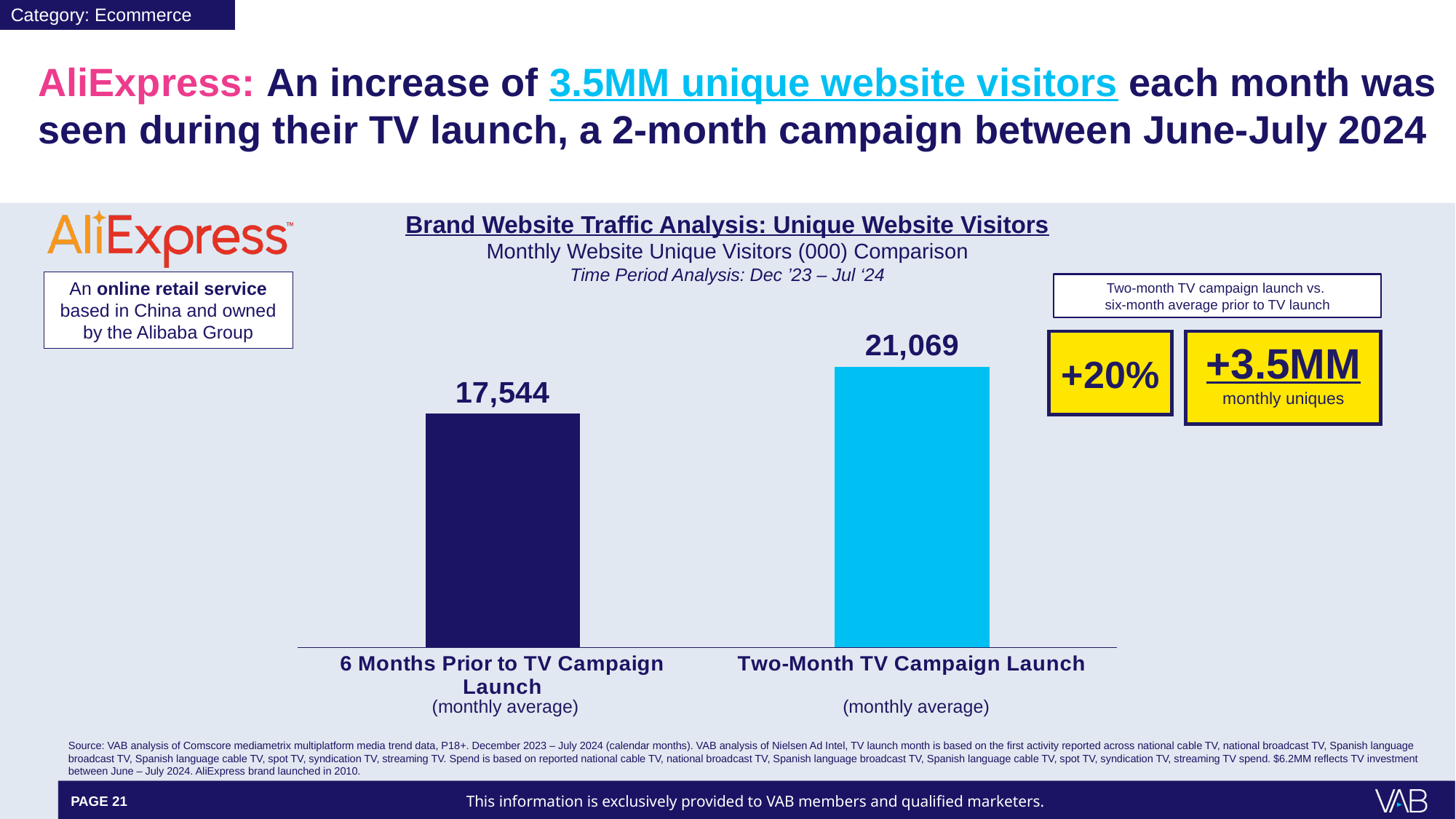
How many bars are plotted in the chart? 2 Do the values rise or fall from the 6 Months Prior bar to the Two-Month TV Campaign Launch bar? rise Which period has the higher monthly average of unique website visitors? Two-Month TV Campaign Launch What kind of chart is shown on the slide? bar chart What is the title of the chart? Brand Website Traffic Analysis: Unique Website Visitors What percentage increase is shown in the callout box next to the chart? +20% What is the difference in monthly unique visitors (000) between the Two-Month TV Campaign Launch and the 6 Months Prior to TV Campaign Launch? 3,525 What is the monthly average of unique website visitors (000) for the Two-Month TV Campaign Launch? 21,069 What is the monthly average of unique website visitors (000) for the 6 Months Prior to TV Campaign Launch? 17,544 Is the value for the Two-Month TV Campaign Launch larger or smaller than the value for the 6 Months Prior to TV Campaign Launch? larger Which period has the lower monthly average of unique website visitors? 6 Months Prior to TV Campaign Launch